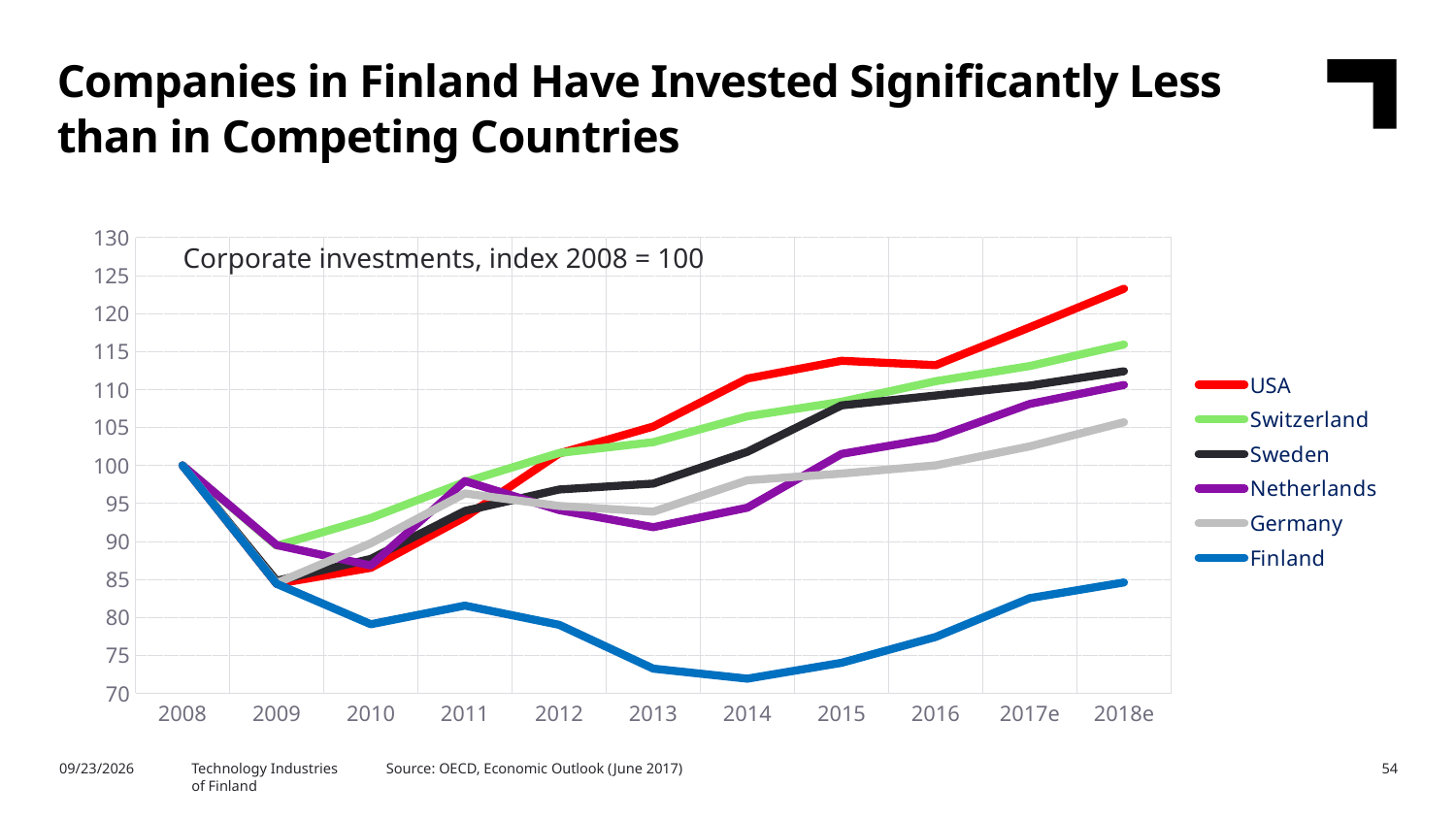
Does the Finland line rise or fall from 2008 to 2014? fall How many series does the legend list? 6 What is the index value for Finland in 2008? 100 How many years are shown along the x axis? 11 Is the value for USA in 2018e greater or less than 120? greater What kind of chart is shown on the slide? line chart Which country has the lowest index value in 2018e? Finland Which is larger in 2016, the value for USA or the value for Finland? USA Which country has the lowest index value in 2010? Finland Which country has the highest index value in 2018e? USA Is the value for Finland in 2014 greater or less than 75? less What subtitle is printed inside the chart area? Corporate investments, index 2008 = 100